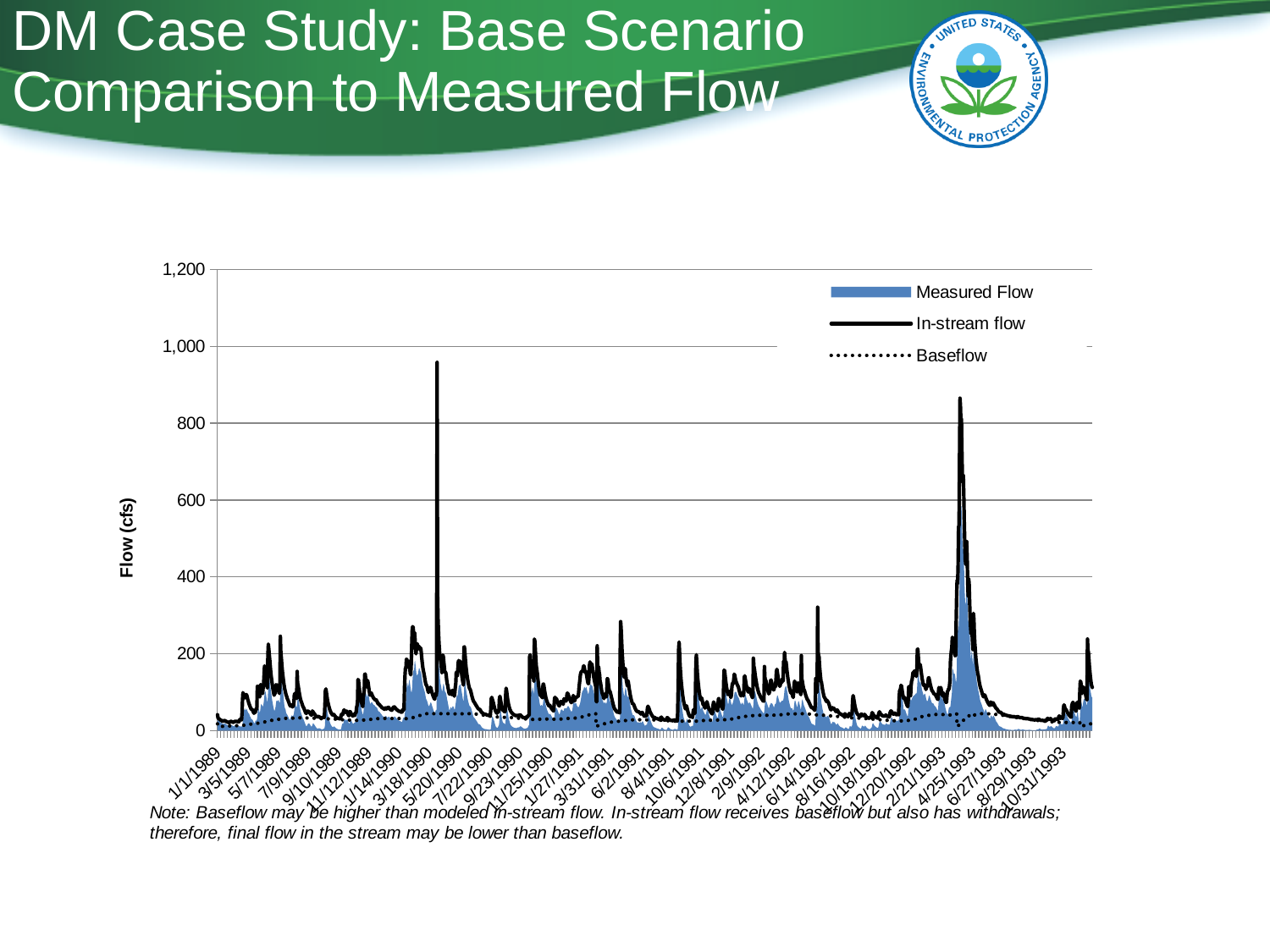
How many series does the legend list? 3 What is the last date shown on the horizontal axis? 10/31/1993 Is the highest peak of the In-stream flow series, near 3/18/1990, greater or less than 800? greater Is the Baseflow series ever greater or less than 200 across the whole period? less What are the three series named in the legend? Measured Flow, In-stream flow, Baseflow What is the first date shown on the horizontal axis? 1/1/1989 Which series is drawn as a dotted line? Baseflow Is the peak of the In-stream flow series near 4/25/1993 greater or less than 600? greater Which series reaches the highest value on the chart, In-stream flow or Baseflow? In-stream flow What is the highest value shown on the vertical axis? 1,200 What is the label on the vertical axis? Flow (cfs)